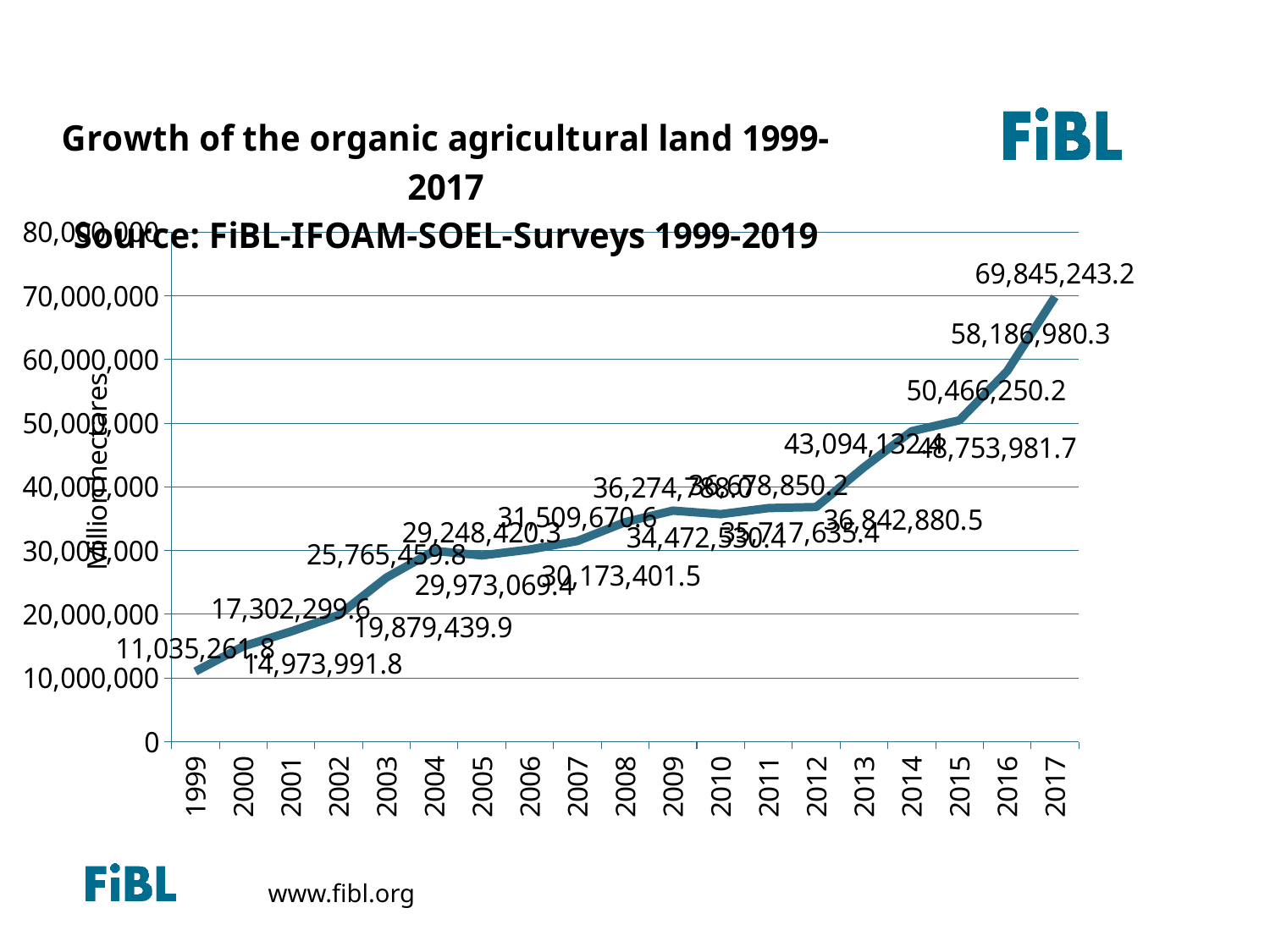
What kind of chart is shown? line chart What is the value for 2015? 50,466,250.2 Which is larger, the value for 2016 or the value for 2015? 2016 How many years are plotted on the x axis? 19 What is the value for 2017? 69,845,243.2 Which year has the lowest value? 1999 What is the value for 2016? 58,186,980.3 What is the value for 1999? 11,035,261.8 Which year has the highest value? 2017 Is the value for 2013 greater or less than 40,000,000? greater Do the values generally rise or fall from 1999 to 2017? rise What is the difference between the values for 2017 and 2016? 11,658,262.9